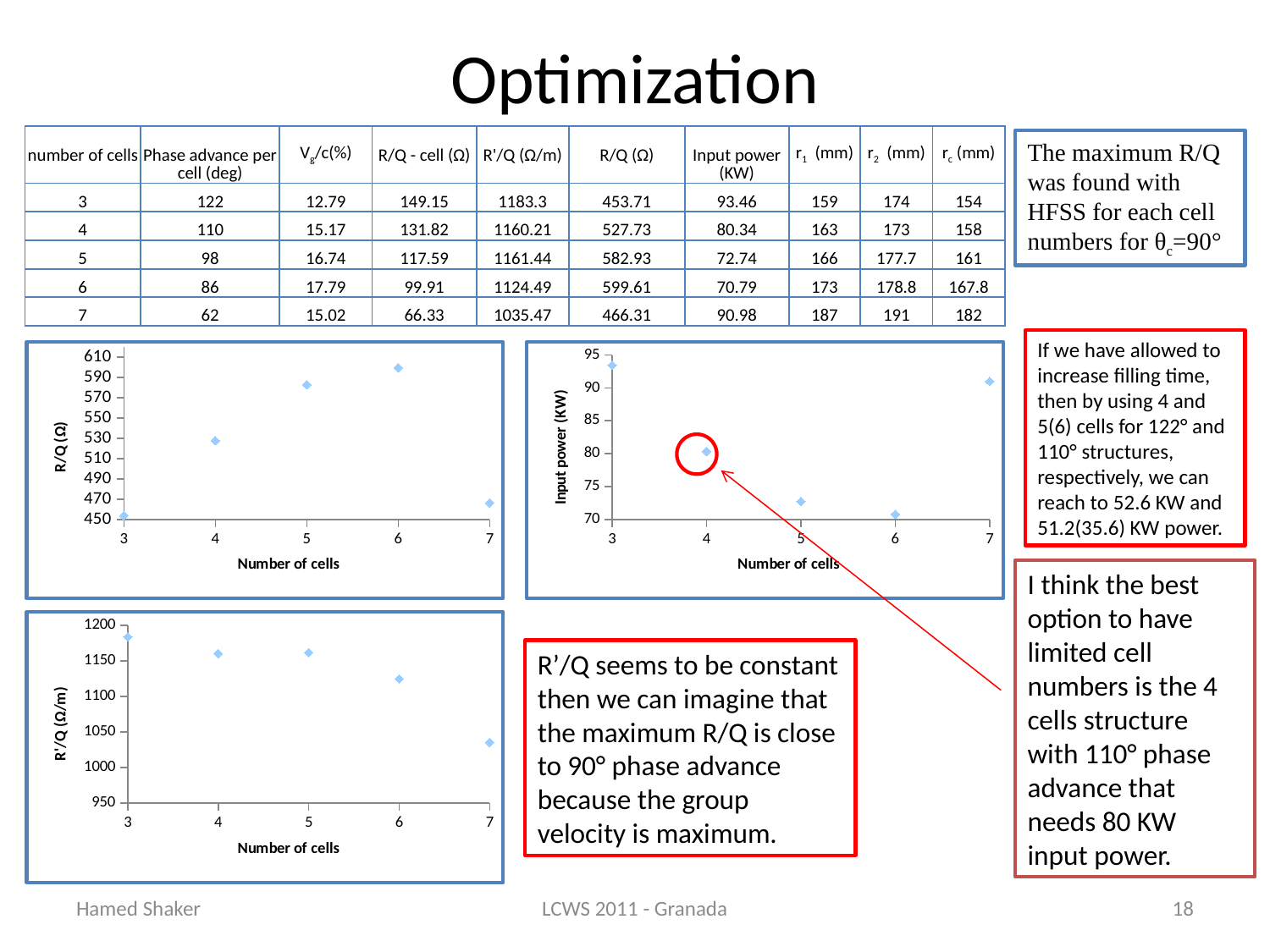
In the top-left R/Q (Ω) chart, how many data points are plotted? 5 In the top-right Input power (KW) chart, is the value for 6 cells greater or less than 75? less In the top-left R/Q (Ω) chart, is the value for 4 cells greater or less than 500? greater In the bottom-left R'/Q (Ω/m) chart, do the values generally rise or fall as the number of cells increases from 3 to 7? fall What kind of chart is the top-left chart with the y axis labelled R/Q (Ω)? scatter chart In the top-left R/Q (Ω) chart, which number of cells has the highest R/Q value? 6 In the top-right Input power (KW) chart, which is larger, the value for 4 cells or the value for 5 cells? 4 cells In the bottom-left R'/Q (Ω/m) chart, which number of cells has the lowest value? 7 In the top-right Input power (KW) chart, is the value for 7 cells greater or less than 85? greater What is the x-axis title of the top-right Input power chart? Number of cells